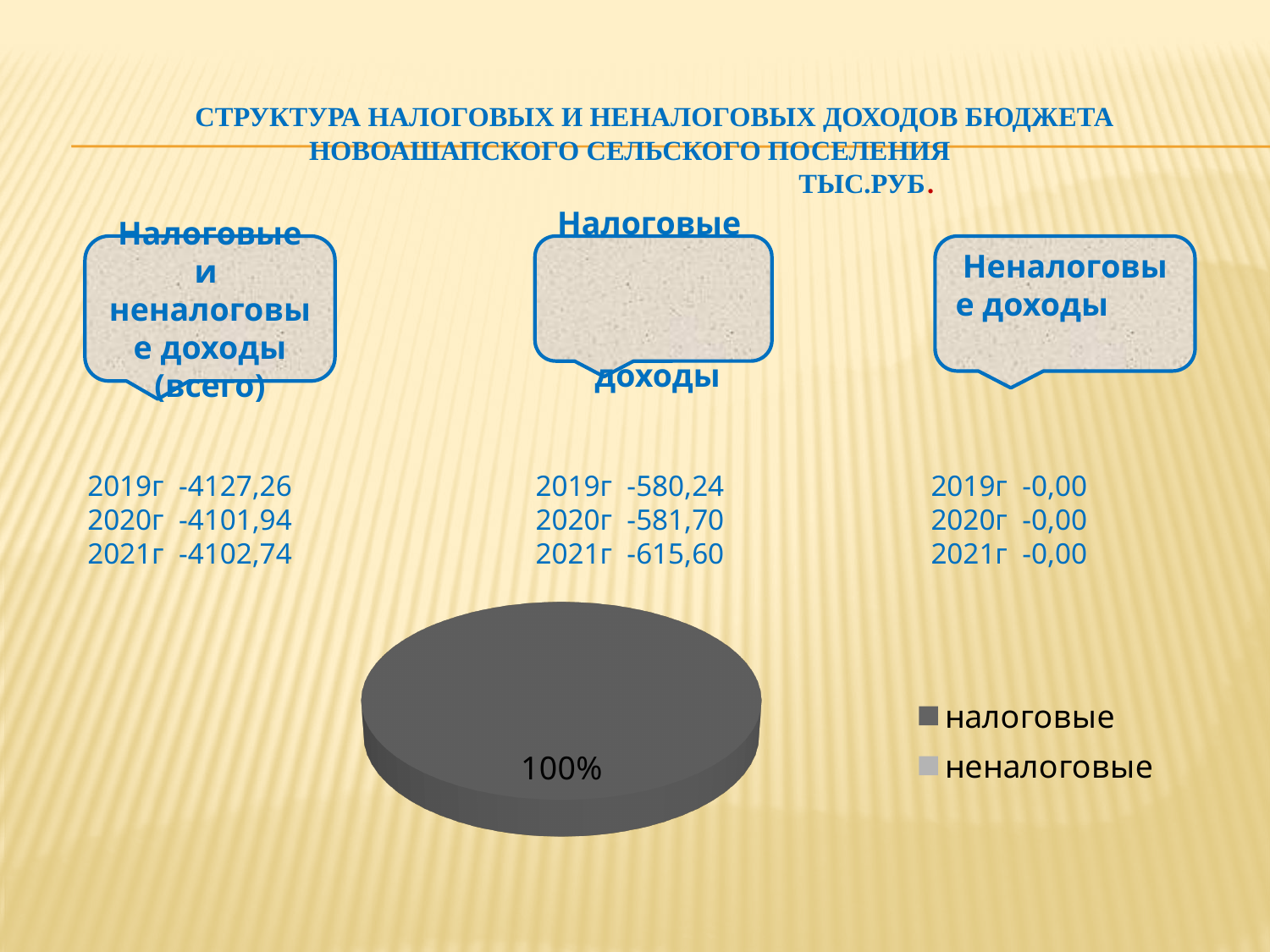
What is the data label printed on the pie chart? 100% Which legend entry is listed first in the pie chart's legend? налоговые What kind of chart is shown on the slide? pie chart What share of the pie chart does the налоговые slice take? 100% How many visible slices does the pie chart have? 1 Which legend entry is listed second in the pie chart's legend? неналоговые Which category makes up the whole pie chart? налоговые How many entries does the pie chart's legend list? 2